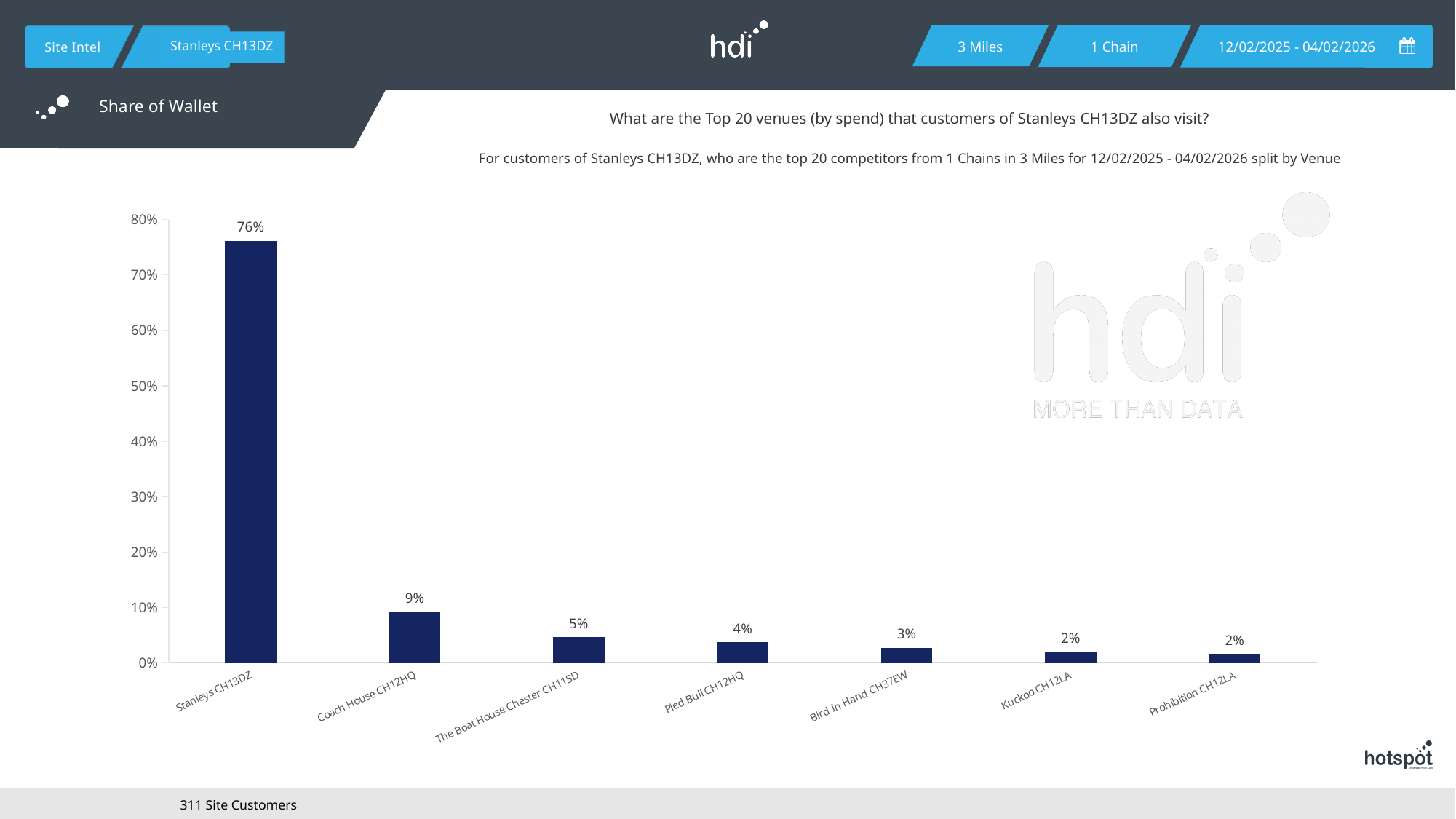
What is the value for Bird In Hand CH37EW? 3% Do the values rise or fall from left to right along the x axis? fall Which venue has the highest value? Stanleys CH13DZ What is the value for Coach House CH12HQ? 9% What is the value for The Boat House Chester CH11SD? 5% What is the value for Stanleys CH13DZ? 76% What is the difference between the values for Coach House CH12HQ and Pied Bull CH12HQ? 5% What kind of chart is shown on the slide? bar chart How many venues are shown on the chart? 7 Is the value for Coach House CH12HQ greater or less than 10%? less Which is larger, the value for Pied Bull CH12HQ or the value for Kuckoo CH12LA? Pied Bull CH12HQ What is the difference between the values for Stanleys CH13DZ and Coach House CH12HQ? 67%